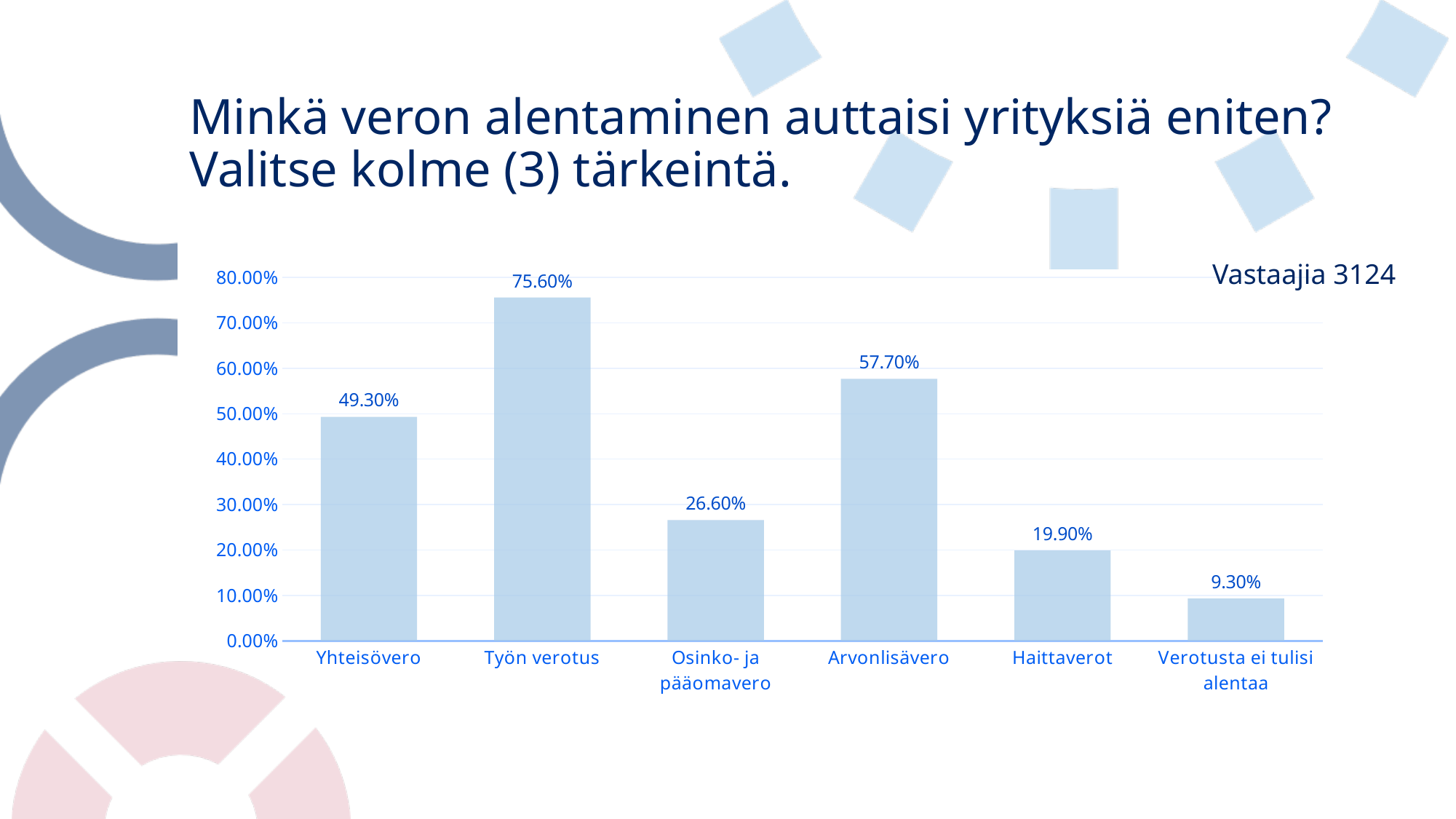
Which category has the highest value? Työn verotus What is the difference between the values for Työn verotus and Yhteisövero? 26.30% How many respondents (Vastaajia) does the slide report? 3124 What is the value for Arvonlisävero? 57.70% Which category has the lowest value? Verotusta ei tulisi alentaa What kind of chart is shown on the slide? bar chart How many categories are shown on the x axis? 6 Which is larger, the value for Osinko- ja pääomavero or the value for Haittaverot? Osinko- ja pääomavero Is the value for Yhteisövero greater or less than 40.00%? greater What is the value for Verotusta ei tulisi alentaa? 9.30% What is the value for Haittaverot? 19.90% What is the value for Työn verotus? 75.60%